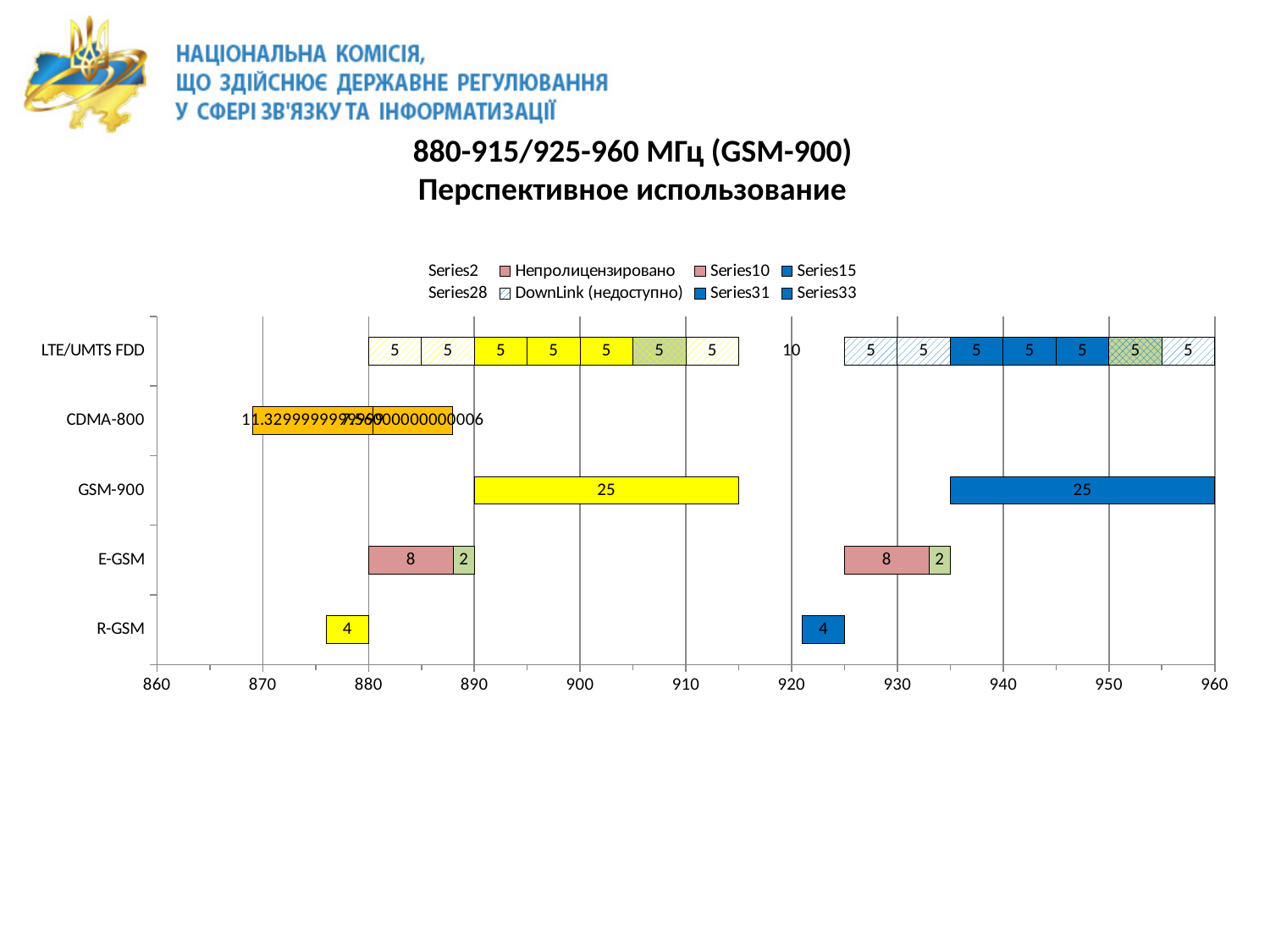
What is the total of the left stacked E-GSM bar (8 and 2)? 10 What is the title of the chart on the slide? 880-915/925-960 МГц (GSM-900) Перспективное использование What is the difference between the pink segment (8) and the green segment (2) of the left E-GSM bar? 6 What kind of chart is shown on the slide? bar chart How many categories are listed on the vertical axis of the chart? 5 How many series does the chart legend list? 8 What value is labelled on the pink segment of the left E-GSM bar? 8 What value is labelled on the green segment of the left E-GSM bar? 2 Which is larger: the yellow GSM-900 bar or the yellow R-GSM bar? GSM-900 What value is labelled on the yellow bar for GSM-900? 25 What value is labelled on the yellow bar for R-GSM? 4 What value is labelled on the blue bar for GSM-900? 25